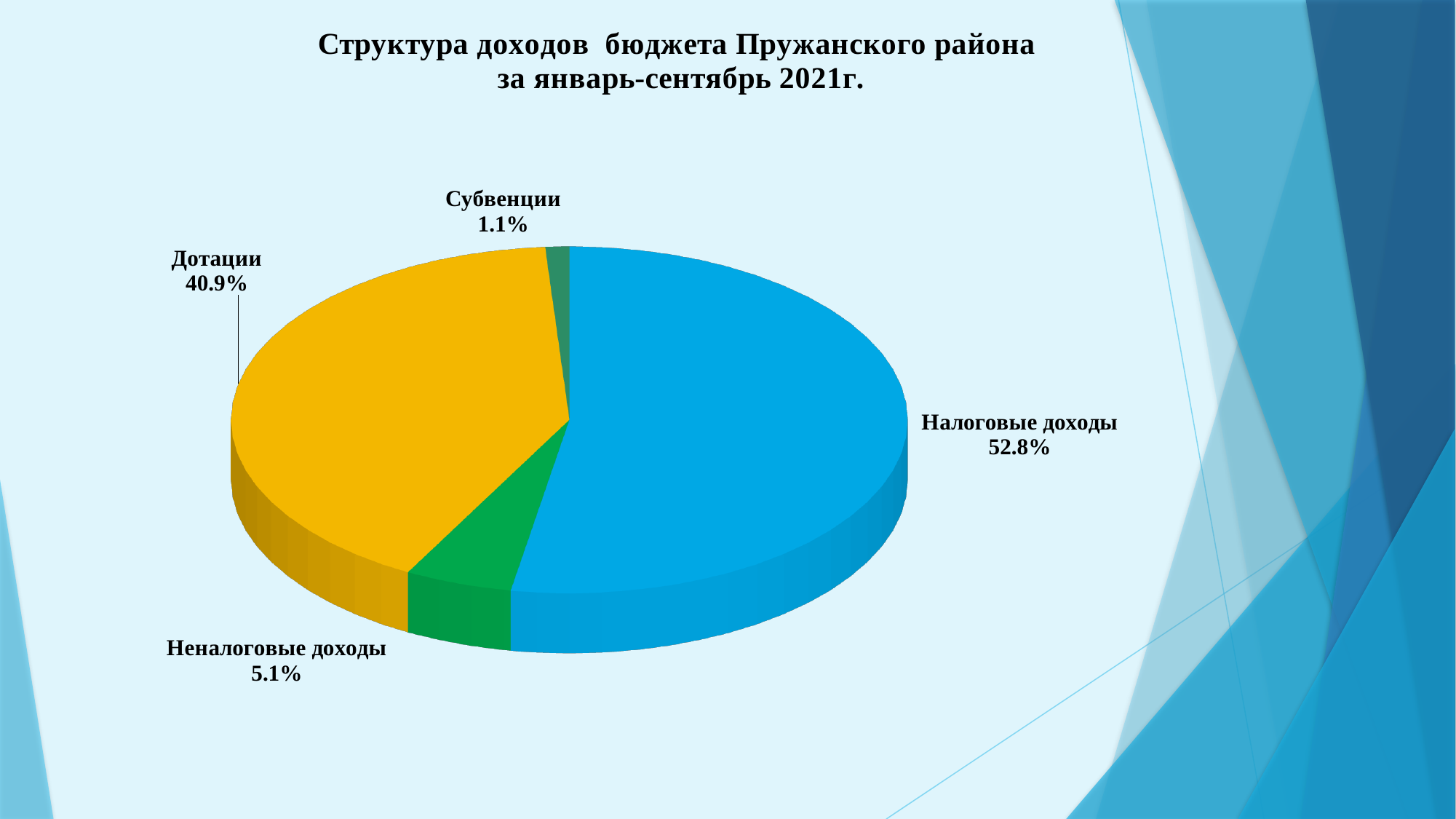
What is the value shown for Субвенции? 1.1% How many categories are shown in the pie chart? 4 Which category has the smallest slice of the pie? Субвенции Which is larger, the share of Дотации or the share of Неналоговые доходы? Дотации What is the difference between the shares of Неналоговые доходы and Субвенции? 4.0% What is the difference between the shares of Налоговые доходы and Дотации? 11.9% What is the title of the chart? Структура доходов бюджета Пружанского района за январь-сентябрь 2021г. What share of the pie does Налоговые доходы have? 52.8% What is the value shown for Дотации? 40.9% Which category has the largest slice of the pie? Налоговые доходы What is the value shown for Неналоговые доходы? 5.1% What kind of chart is shown on the slide? Pie chart